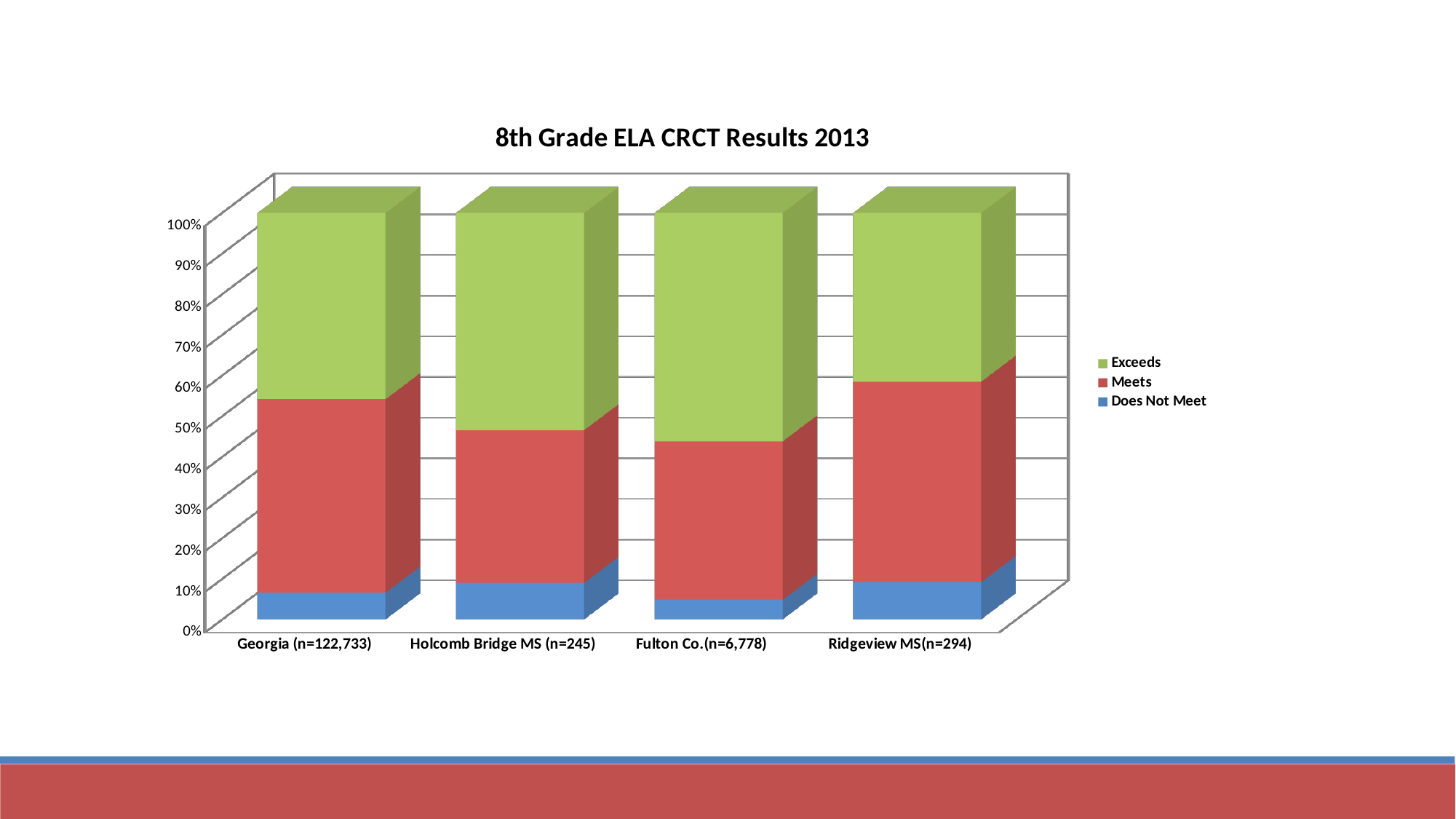
How many series does the legend list? 3 Is the Exceeds value for Georgia (n=122,733) greater or less than 50%? less What is the title of the chart? 8th Grade ELA CRCT Results 2013 Which has the larger Exceeds segment, Georgia (n=122,733) or Ridgeview MS(n=294)? Georgia (n=122,733) Which series is shown in green in the legend? Exceeds What is the total height of each stacked bar on the percentage axis? 100% Is the Exceeds value for Ridgeview MS(n=294) greater or less than 50%? less Is the Does Not Meet value for Fulton Co.(n=6,778) greater or less than 10%? less What kind of chart is shown on the slide? Stacked bar chart Which category has the smallest Does Not Meet segment? Fulton Co.(n=6,778) How many categories are shown along the x axis? 4 Which has the larger Does Not Meet segment, Holcomb Bridge MS (n=245) or Fulton Co.(n=6,778)? Holcomb Bridge MS (n=245)